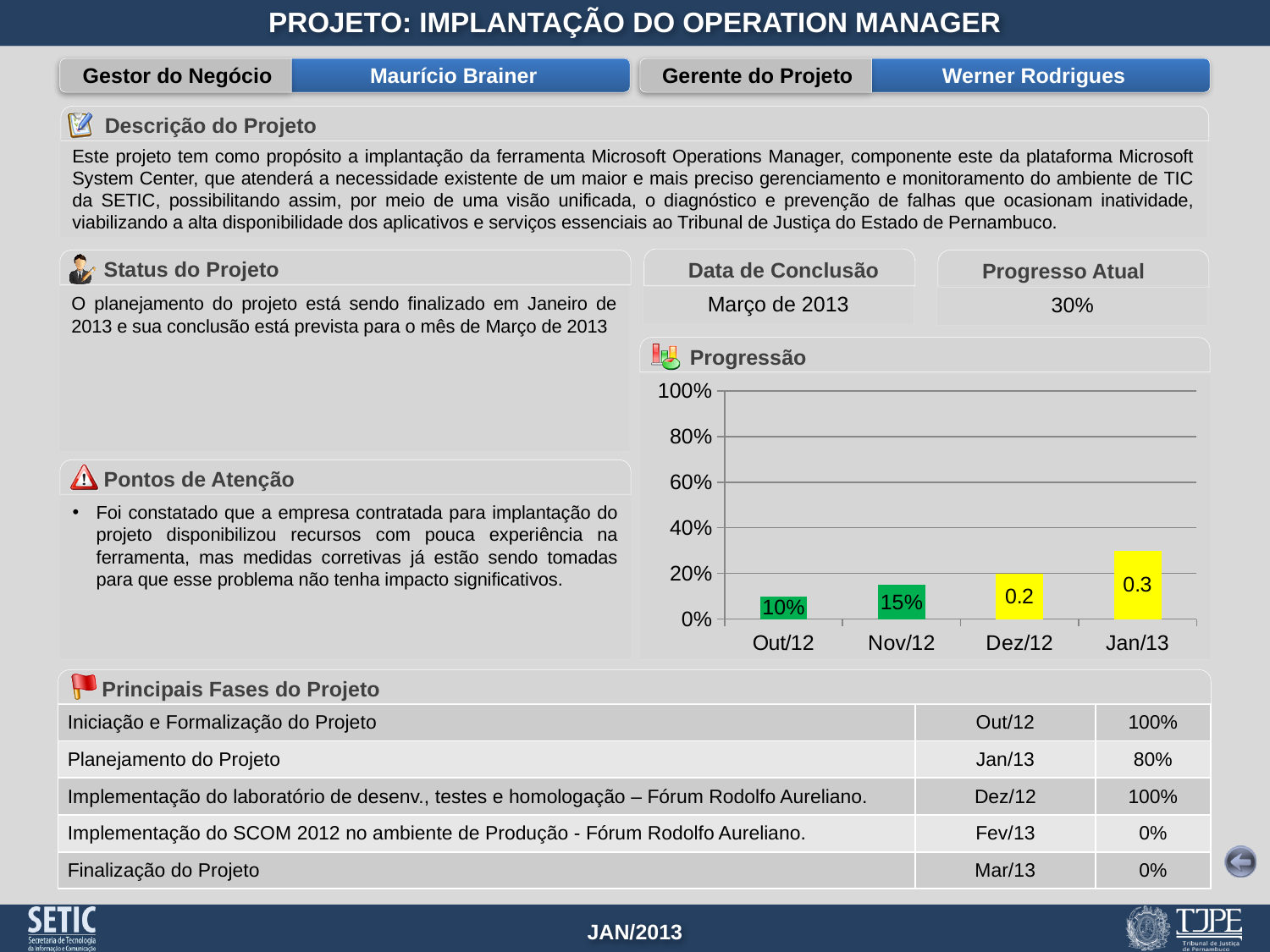
In the Progressão chart, is the value for Jan/13 greater or less than 20%? greater What kind of chart is the Progressão chart? bar chart In the Progressão chart, what is the value shown for Out/12? 10% In the Progressão chart, what is the data label shown on the Dez/12 bar? 0.2 How many months are shown on the x axis of the Progressão chart? 4 In the Progressão chart, which month has the highest bar? Jan/13 In the Progressão chart, what is the difference between the values for Nov/12 and Out/12? 5% In the Progressão chart, what is the data label shown on the Jan/13 bar? 0.3 In the Progressão chart, which is larger, the value for Out/12 or the value for Nov/12? Nov/12 In the Progressão chart, which month has the lowest bar? Out/12 In the Progressão chart, do the values rise or fall from Out/12 to Jan/13? rise In the Progressão chart, what is the value shown for Nov/12? 15%